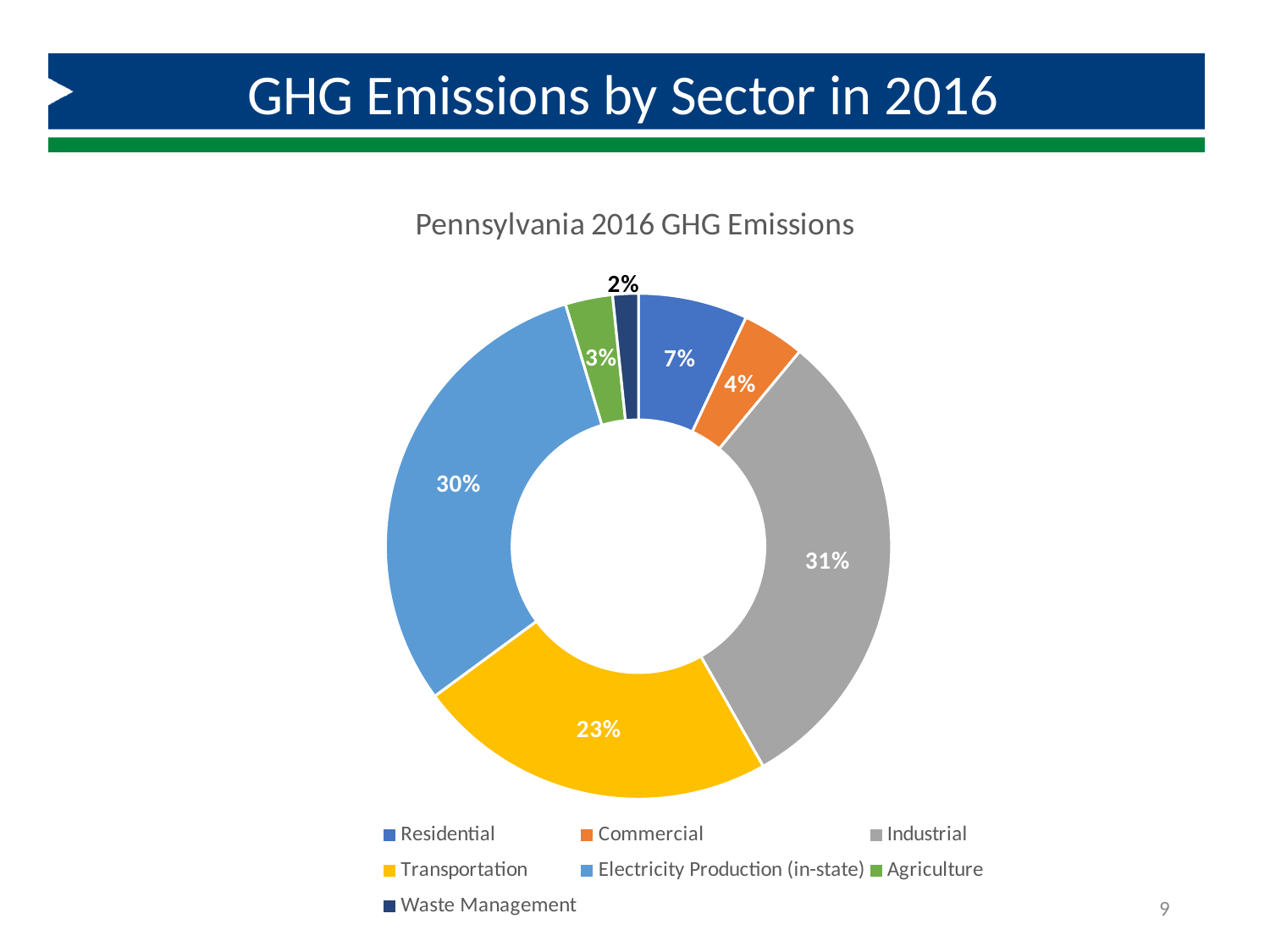
What percentage of emissions comes from the Residential sector? 7% What share does Agriculture account for? 3% What is the share for Electricity Production (in-state)? 30% Which has a larger share, Residential or Commercial? Residential How many sectors are shown in the chart? 7 What type of chart is used on this slide? doughnut chart What percentage of emissions is attributed to Transportation? 23% What is the title of the chart? Pennsylvania 2016 GHG Emissions What is the difference in percentage points between the Industrial and Transportation shares? 8 What share of Pennsylvania 2016 GHG emissions comes from the Industrial sector? 31% Which sector has the largest share of emissions? Industrial Which sector has the smallest share of emissions? Waste Management